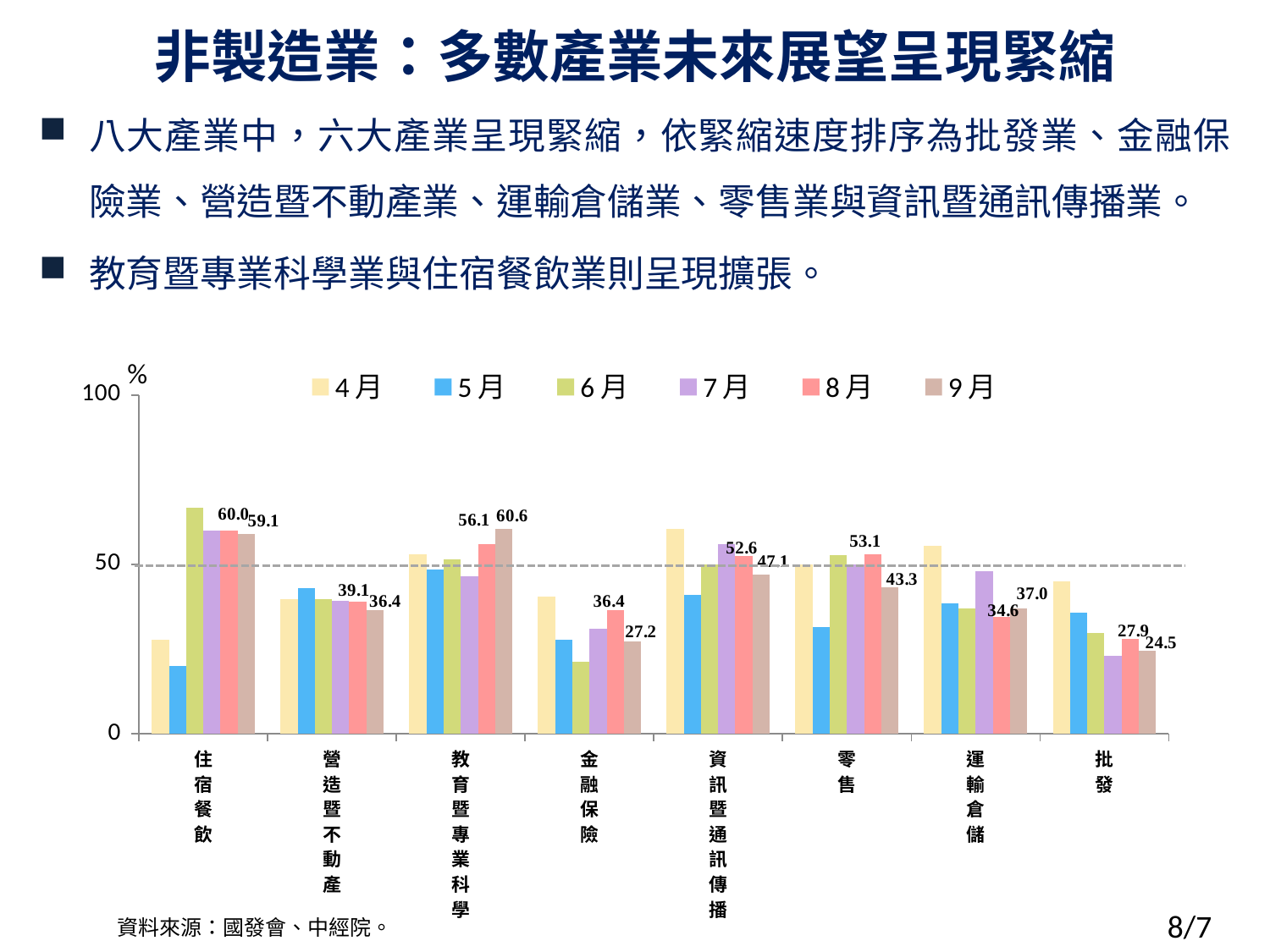
What is the 9月 value for 批發? 24.5 What kind of chart is shown on the slide? bar chart Which is larger for 運輸倉儲, the 8月 value or the 9月 value? 9月 How many series does the legend list? 6 What is the difference between the 8月 and 9月 values for 金融保險? 9.2 What is the 9月 value for 教育暨專業科學? 60.6 What is the 8月 value for 零售? 53.1 Which category has the highest 9月 value? 教育暨專業科學 How many industry categories are shown on the x axis? 8 Is the 5月 value for 住宿餐飲 greater or less than 50? less Which category has the lowest 9月 value? 批發 Is the 4月 value for 資訊暨通訊傳播 greater or less than 50? greater